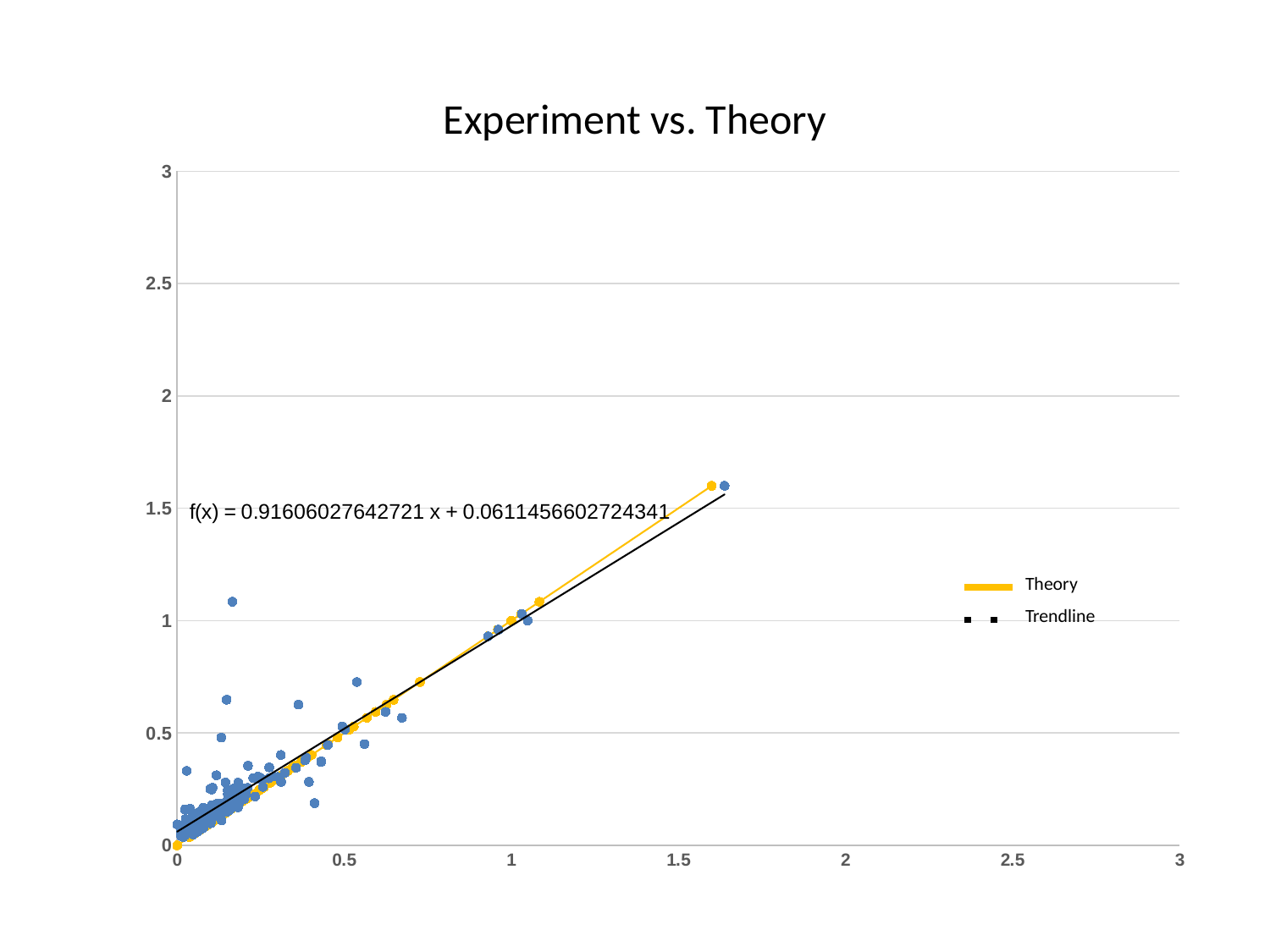
What is the slope of the trendline equation shown on the chart? 0.91606027642721 Do the plotted values rise or fall as x increases along the x axis? rise What is the title of the chart? Experiment vs. Theory What kind of chart is shown on the slide? scatter chart What is the maximum value shown on the x axis? 3 What is the intercept of the trendline equation shown on the chart? 0.0611456602724341 Is the x value of the rightmost plotted point greater or less than 1.5? greater Is the y value of the highest plotted point greater or less than 2? less What is the maximum value shown on the y axis? 3 Which two entries appear in the chart legend? Theory and Trendline How many series does the legend list? 2 Is the y value of the highest plotted point greater or less than 1.5? greater